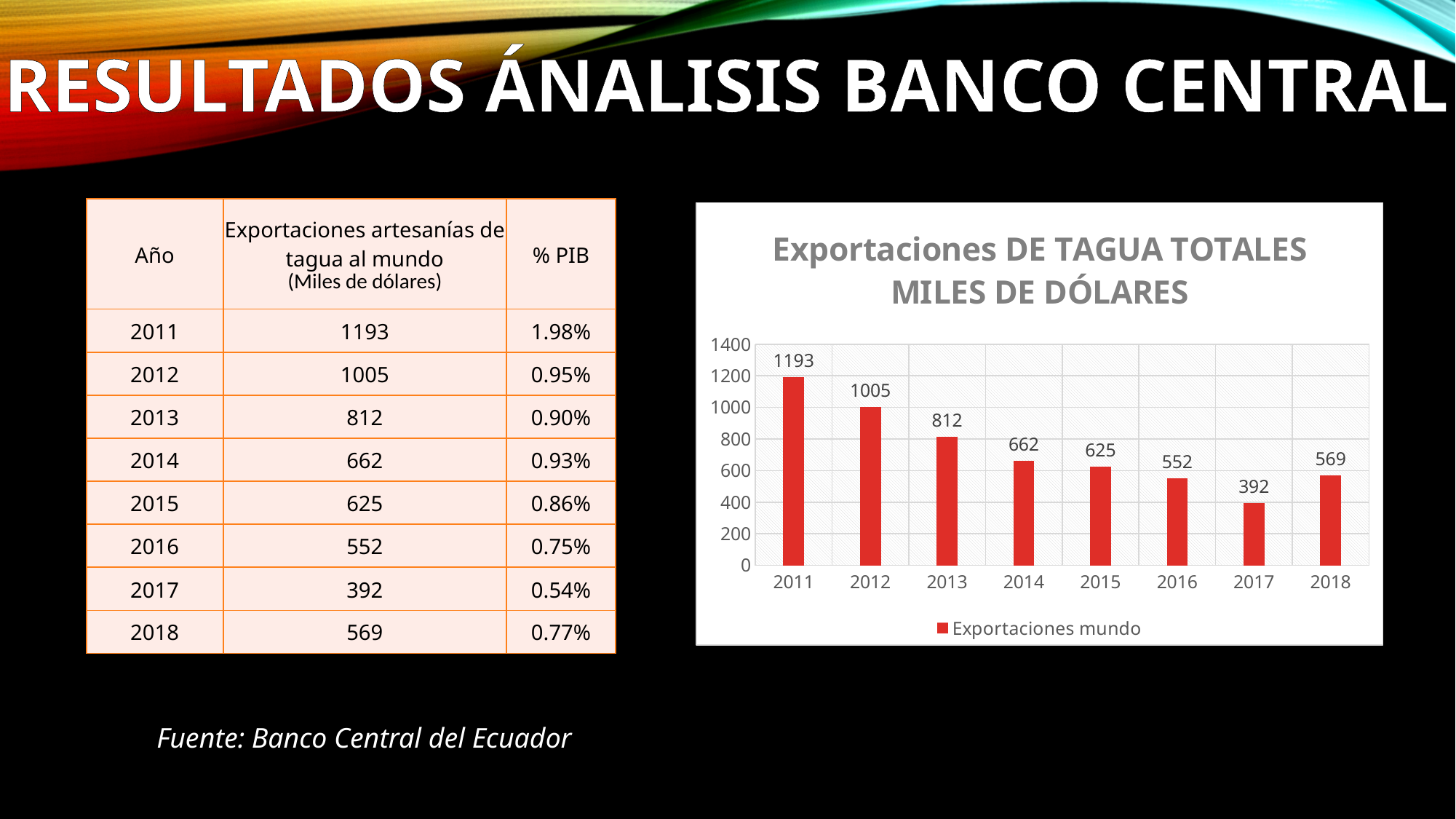
Is the value for 2013 greater or less than 800? greater What kind of chart is shown on the slide? bar chart What is the value for 2017 in the chart? 392 What is the difference between the values for 2018 and 2017? 177 Which is larger, the value for 2014 or the value for 2015? 2014 What series name does the chart legend show? Exportaciones mundo Which year has the highest value in the chart? 2011 Which year has the lowest value in the chart? 2017 What is the value for 2011 in the chart? 1193 What is the difference between the values for 2011 and 2012? 188 How many years are shown on the x axis of the chart? 8 What is the value for 2018 in the chart? 569